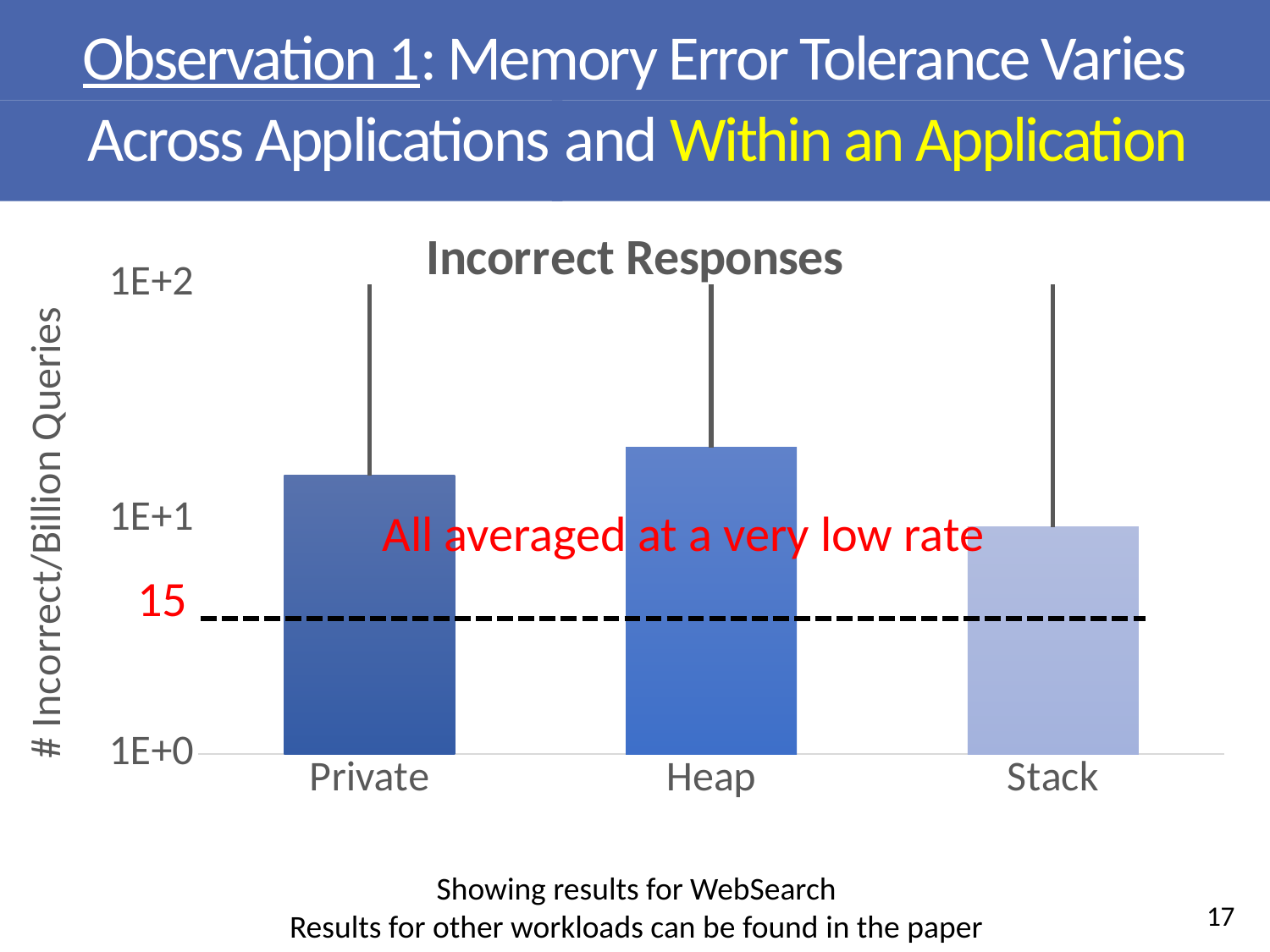
Which category has the highest bar in the chart? Heap Is the value for Heap greater or less than 1E+2? less What is the label on the vertical axis of the chart? # Incorrect/Billion Queries Which has a larger value, Private or Stack? Private Which has a larger value, Private or Heap? Heap Is the value for Stack greater or less than 1E+2? less How many categories are shown on the x axis of the chart? 3 What is the title of the chart? Incorrect Responses Is the value for Heap greater or less than 1E+1? greater Which category has the lowest bar in the chart? Stack What type of chart is shown on the slide? bar chart